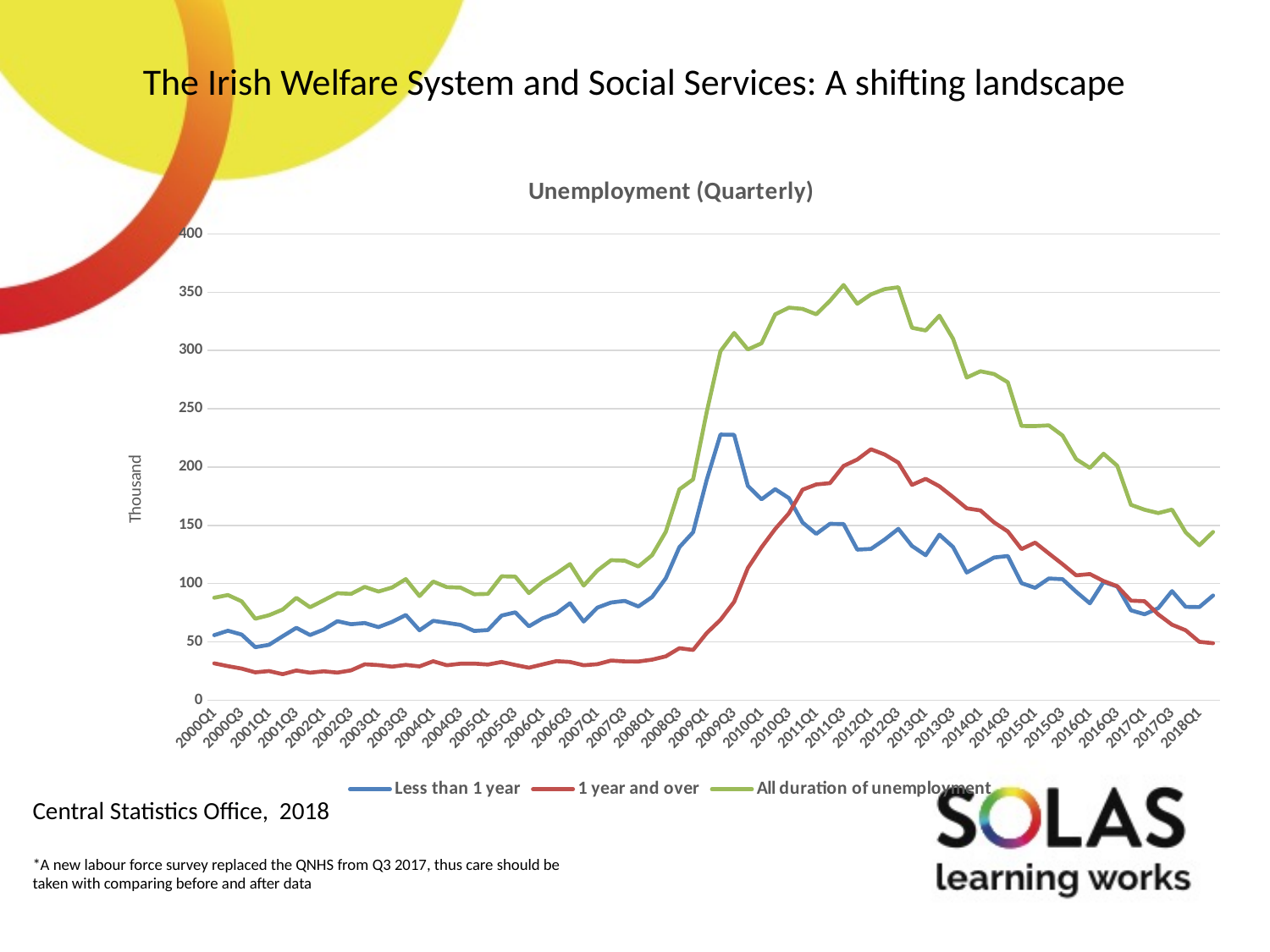
Is the value for All duration of unemployment at 2012Q1 greater or less than 300? greater At 2009Q3, which is larger: Less than 1 year or 1 year and over? Less than 1 year What kind of chart is shown on the slide? line chart Is the value for All duration of unemployment at 2018Q1 greater or less than 200? less How many series does the legend of the Unemployment (Quarterly) chart list? 3 Does the All duration of unemployment line rise or fall from 2012Q3 to 2018Q1? fall Is the value for 1 year and over at 2000Q1 greater or less than 50? less Which series reaches the highest peak on the chart? All duration of unemployment What is the title of the chart on the slide? Unemployment (Quarterly) At 2012Q1, which is larger: Less than 1 year or 1 year and over? 1 year and over What unit is shown on the vertical axis of the chart? Thousand